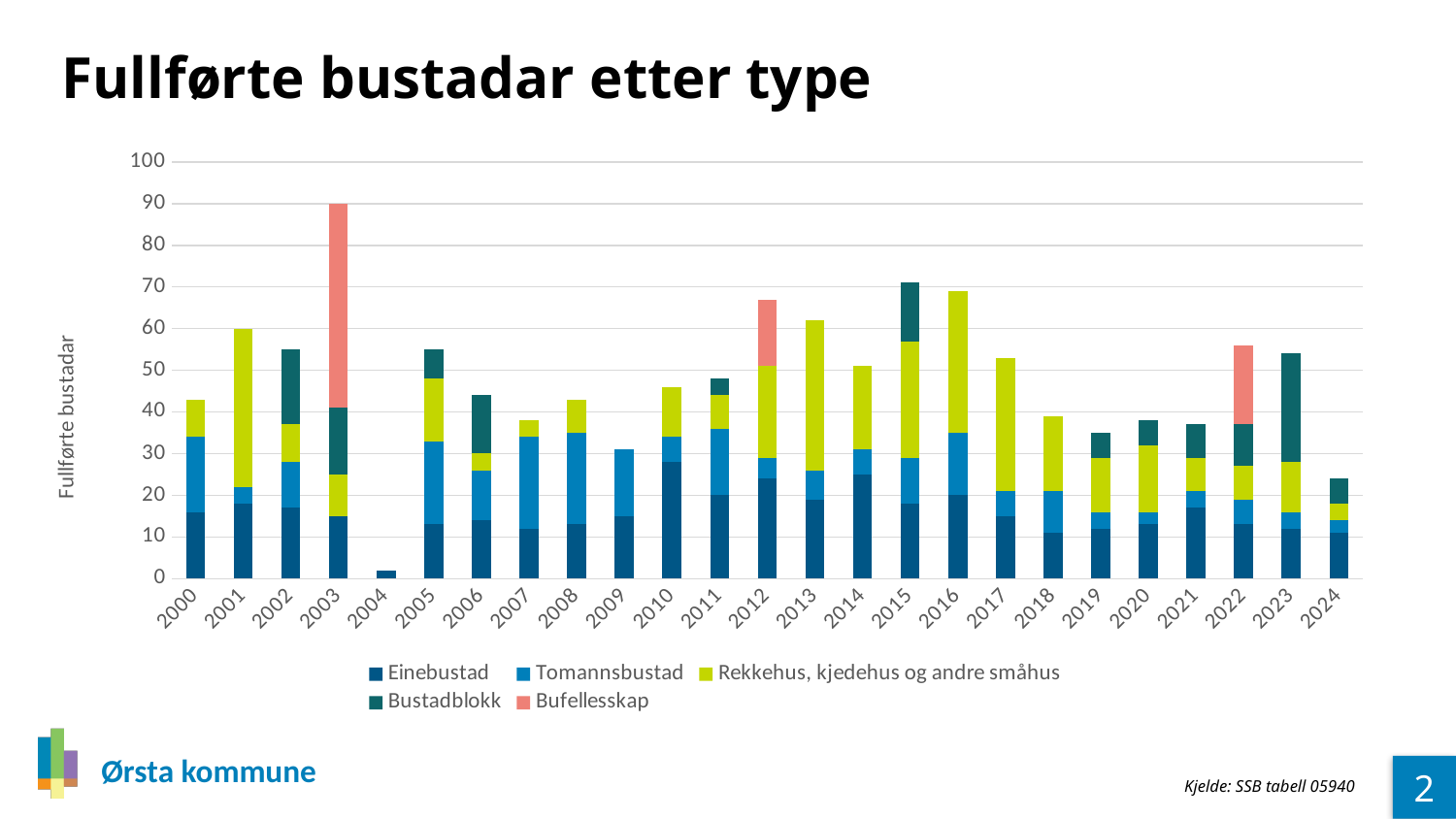
Which year has the highest total of completed dwellings? 2003 What kind of chart is shown on the slide? Stacked bar chart Is the total for 2012 greater or less than 60? greater How many series does the legend list? 5 Is the total for 2003 greater or less than 80? greater How many years are shown along the x axis? 25 Which year has a larger total, 2016 or 2024? 2016 Is the total for 2024 greater or less than 30? less What is the label on the y axis? Fullførte bustadar Which series is shown in the pink/salmon colour in the legend? Bufellesskap Which year has the lowest total of completed dwellings? 2004